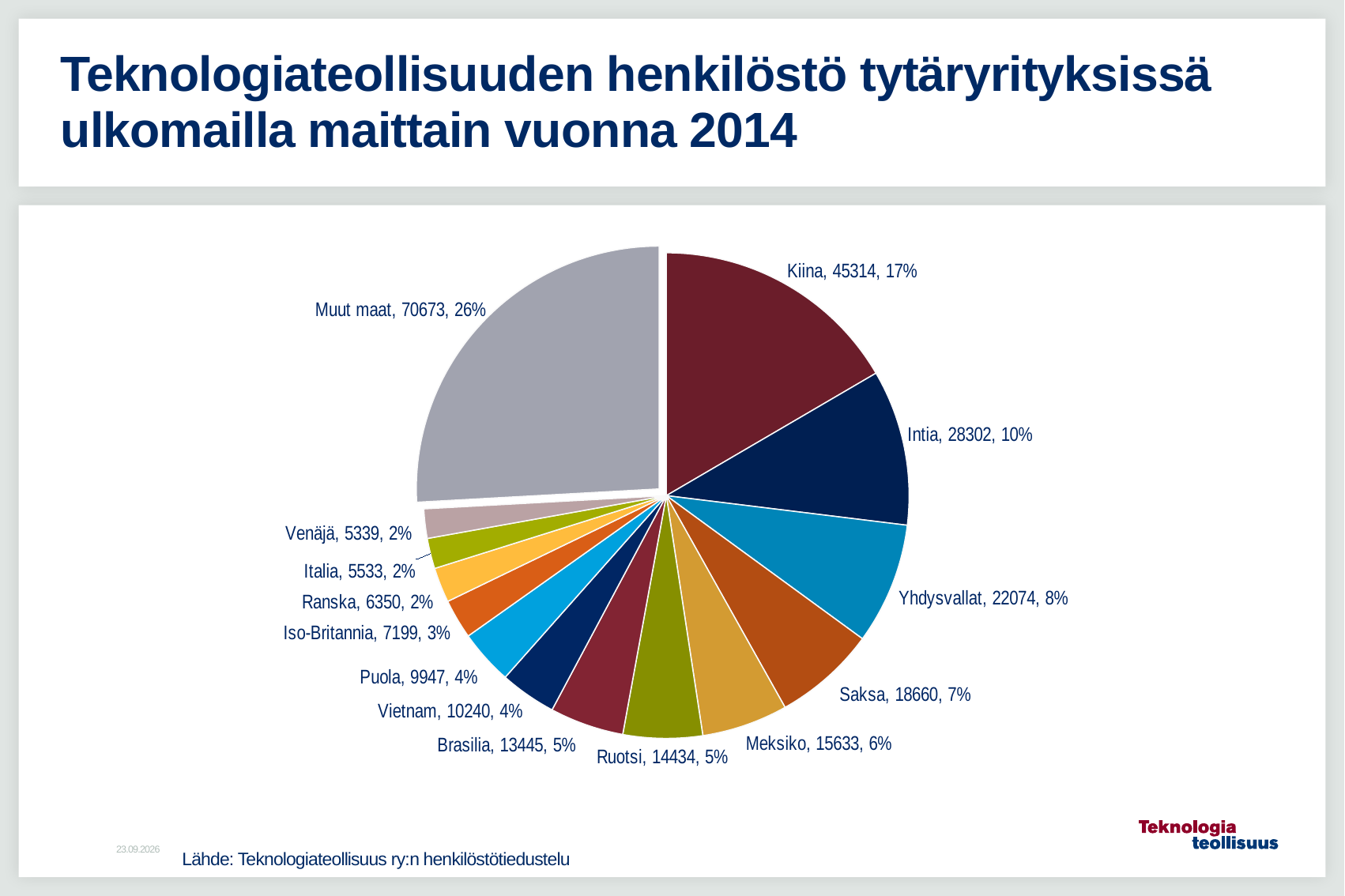
Which slice has the smallest value? Venäjä What is the value shown for Kiina? 45314 How many slices does the pie chart have? 14 What is the title of the chart on the slide? Teknologiateollisuuden henkilöstö tytäryrityksissä ulkomailla maittain vuonna 2014 Which slice has the largest value? Muut maat What is the difference between the values for Kiina and Intia? 17012 What share of the pie does Kiina represent? 17% What is the value shown for Yhdysvallat? 22074 Which is larger, the value for Saksa or the value for Meksiko? Saksa What is the value shown for Vietnam? 10240 What type of chart is shown on the slide? pie chart What share of the pie does Muut maat represent? 26%